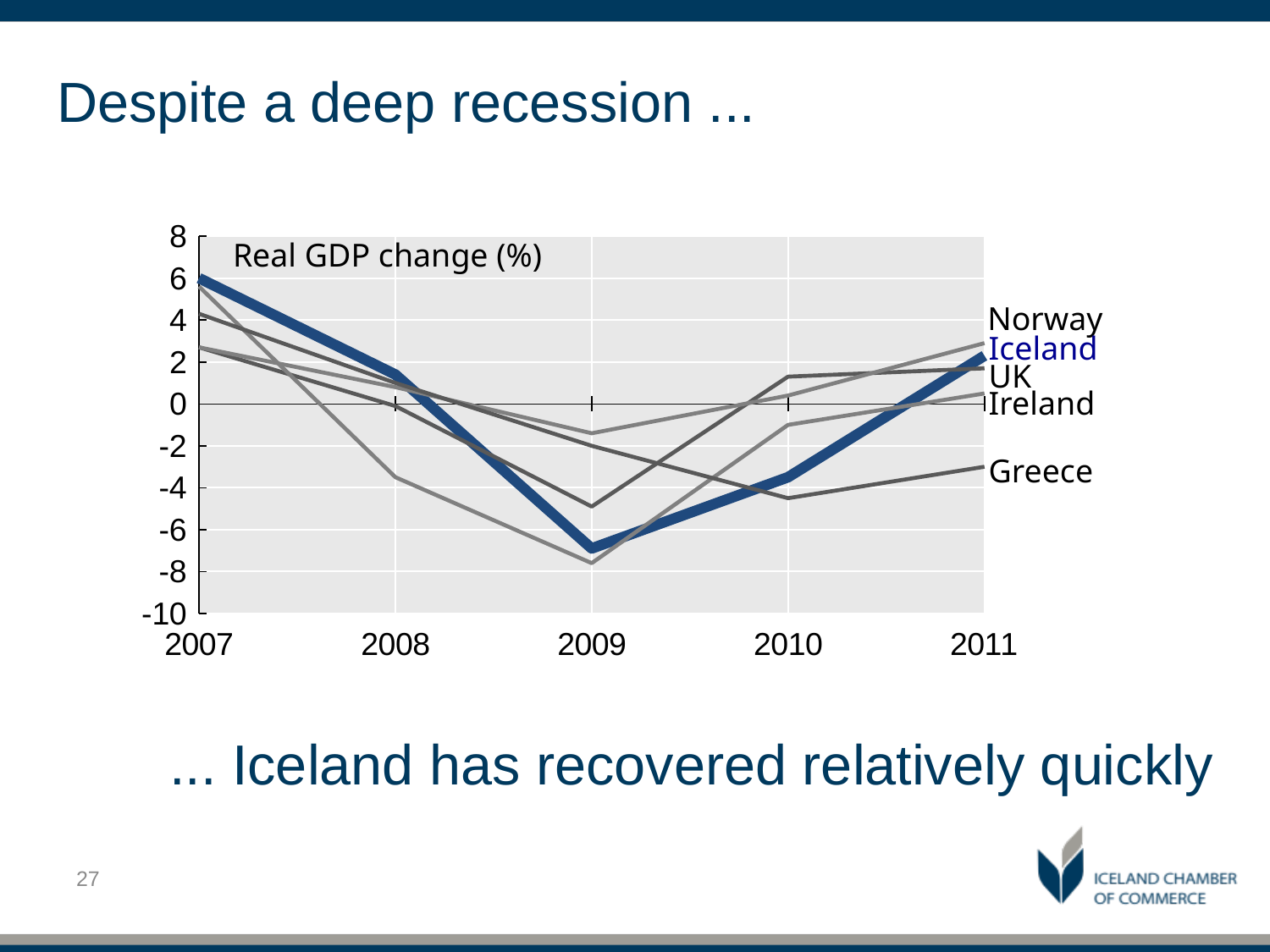
Is the value for Iceland in 2007 greater or less than 4? greater Does Iceland's real GDP change rise or fall from 2009 to 2011? rise What is the title printed inside the chart area? Real GDP change (%) How many years are shown along the x axis? 5 Which country has the lowest real GDP change in 2011? Greece Which country has the highest real GDP change in 2011? Norway How many countries are plotted on the chart? 5 What kind of chart is shown on the slide? line chart Which country's line is drawn in thick blue? Iceland Is the value for Greece in 2011 greater or less than -2? less Which country has the lowest real GDP change in 2010? Greece Is the value for Iceland in 2009 greater or less than -6? less